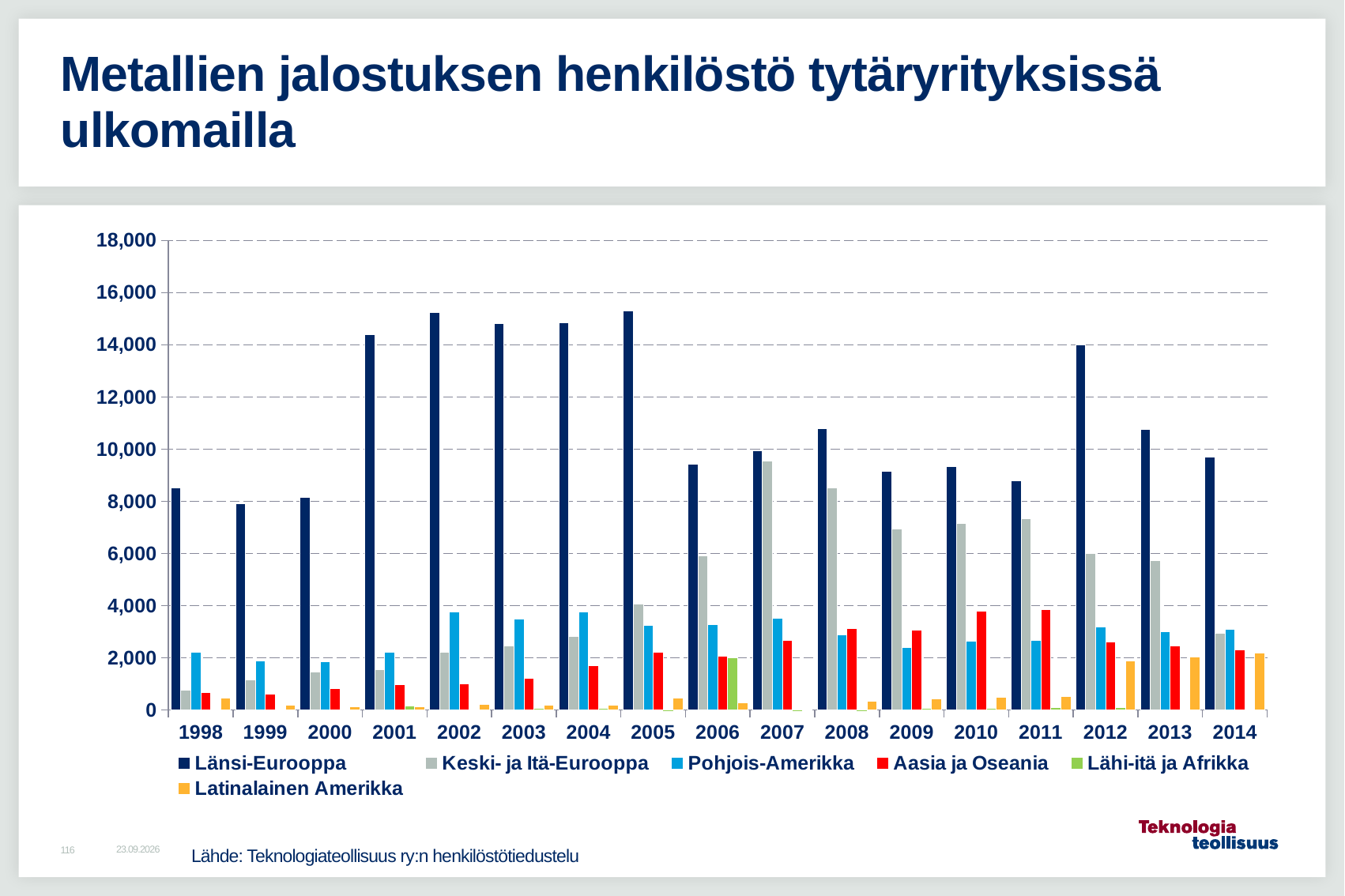
How many years are shown on the x axis? 17 Which is larger for Länsi-Eurooppa: the value in 2005 or the value in 2006? 2005 Is the value for Pohjois-Amerikka in 2002 greater or less than 2,000? greater In 2008, which is larger: Länsi-Eurooppa or Keski- ja Itä-Eurooppa? Länsi-Eurooppa In which year is the value for Keski- ja Itä-Eurooppa highest? 2007 Is the value for Keski- ja Itä-Eurooppa in 2007 greater or less than 8,000? greater In which year is the value for Lähi-itä ja Afrikka highest? 2006 Does the value for Keski- ja Itä-Eurooppa rise or fall from 1998 to 2007? rise Is the value for Länsi-Eurooppa in 2005 greater or less than 14,000? greater How many series does the legend list? 6 What kind of chart is shown on the slide? Bar chart